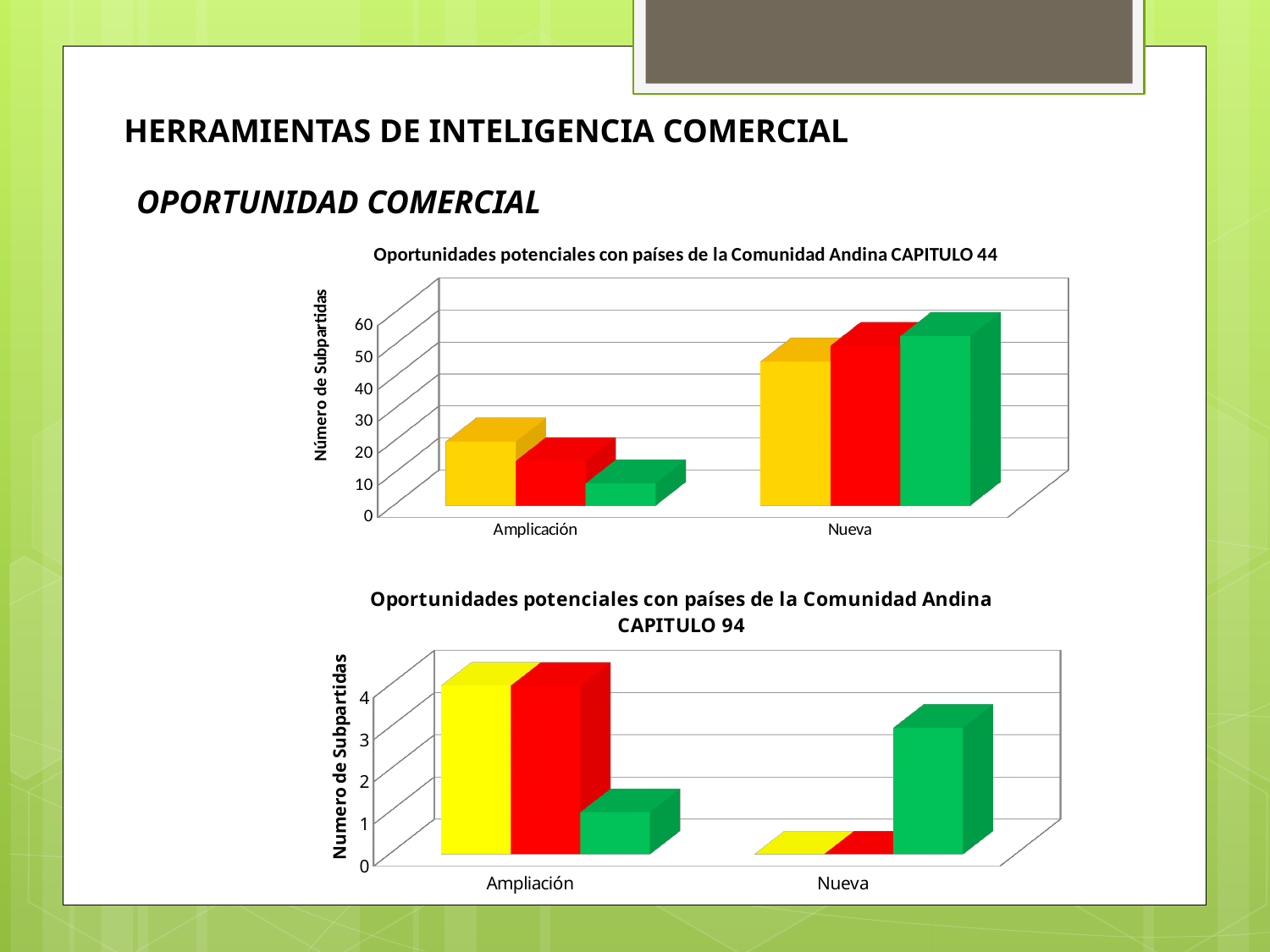
In the top chart (CAPITULO 44), which category has the taller yellow bar, Ampliación or Nueva? Nueva In the top chart (CAPITULO 44), do the values rise or fall from Ampliación to Nueva? rise In the bottom chart (CAPITULO 94), which category has the taller green bar, Ampliación or Nueva? Nueva In the bottom chart (CAPITULO 94), is the value of the green bar for Ampliación greater or less than 2? less In the bottom chart (CAPITULO 94), which category has the taller red bar, Ampliación or Nueva? Ampliación In the bottom chart (CAPITULO 94), is the value of the green bar for Nueva greater or less than 2? greater In the top chart (CAPITULO 44), is the value of the yellow bar for Nueva greater or less than 30? greater What kind of chart is the top chart, 'Oportunidades potenciales con países de la Comunidad Andina CAPITULO 44'? Bar chart What is the y-axis label of the bottom chart (CAPITULO 94)? Numero de Subpartidas What is the title of the top chart on the slide? Oportunidades potenciales con países de la Comunidad Andina CAPITULO 44 How many categories are shown on the x axis of the top chart (CAPITULO 44)? 2